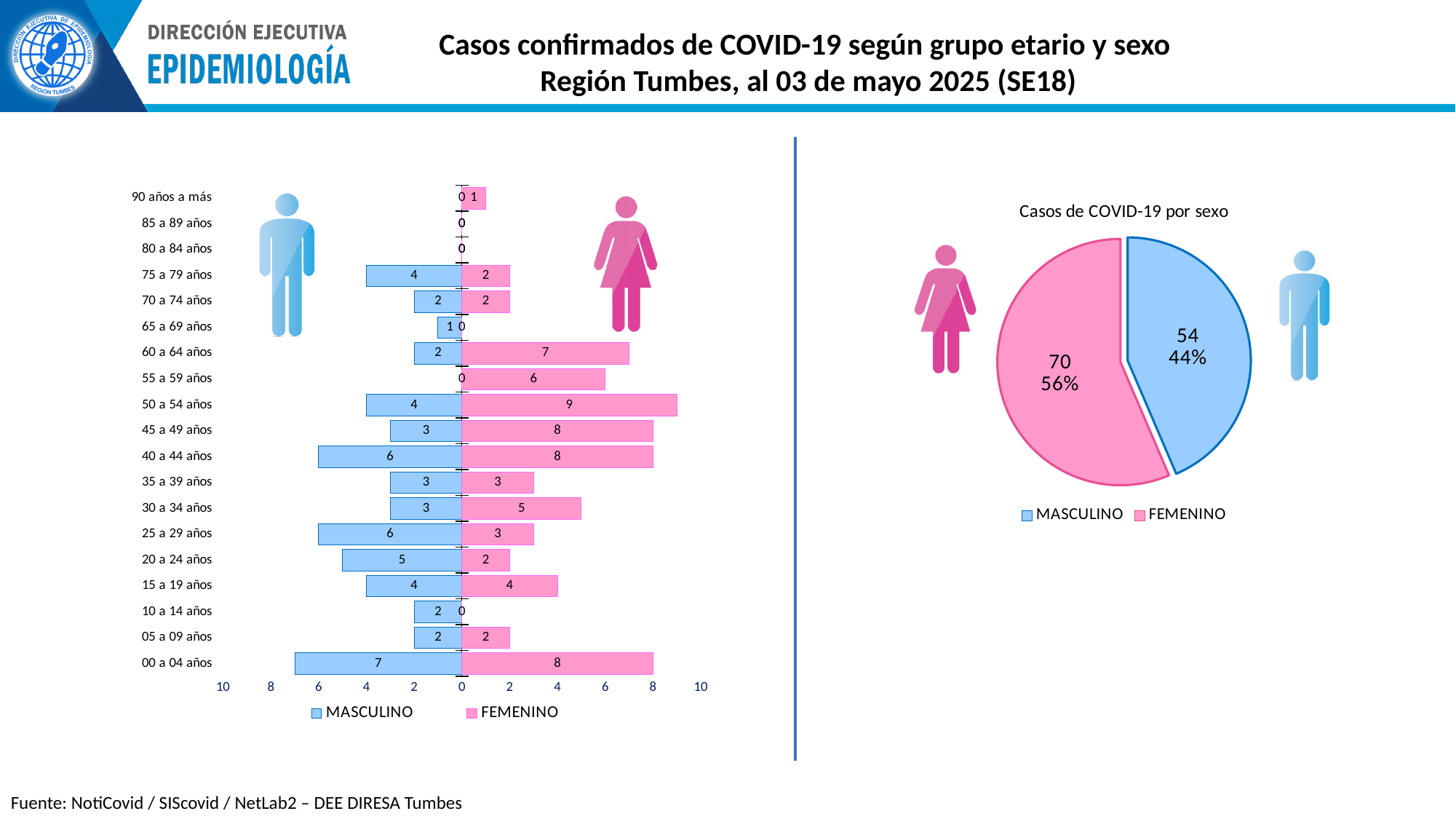
What type of chart is the left chart? Bar chart In the chart 'Casos de COVID-19 por sexo', what share of cases is FEMENINO? 56% In the left chart, how many FEMENINO cases are in the 50 a 54 años group? 9 In the left chart, how many MASCULINO cases are in the 00 a 04 años group? 7 In the chart 'Casos de COVID-19 por sexo', how many MASCULINO cases are there? 54 In the left chart, how many FEMENINO cases are in the 60 a 64 años group? 7 How many series does the legend of the chart 'Casos de COVID-19 por sexo' list? 2 In the left chart, what is the difference between FEMENINO and MASCULINO cases in the 55 a 59 años group? 6 In the left chart, which age group has the highest number of FEMENINO cases? 50 a 54 años In the left chart, which age group has the highest number of MASCULINO cases? 00 a 04 años How many age groups are shown in the left chart? 19 In the left chart, which is larger in the 25 a 29 años group, MASCULINO or FEMENINO? MASCULINO